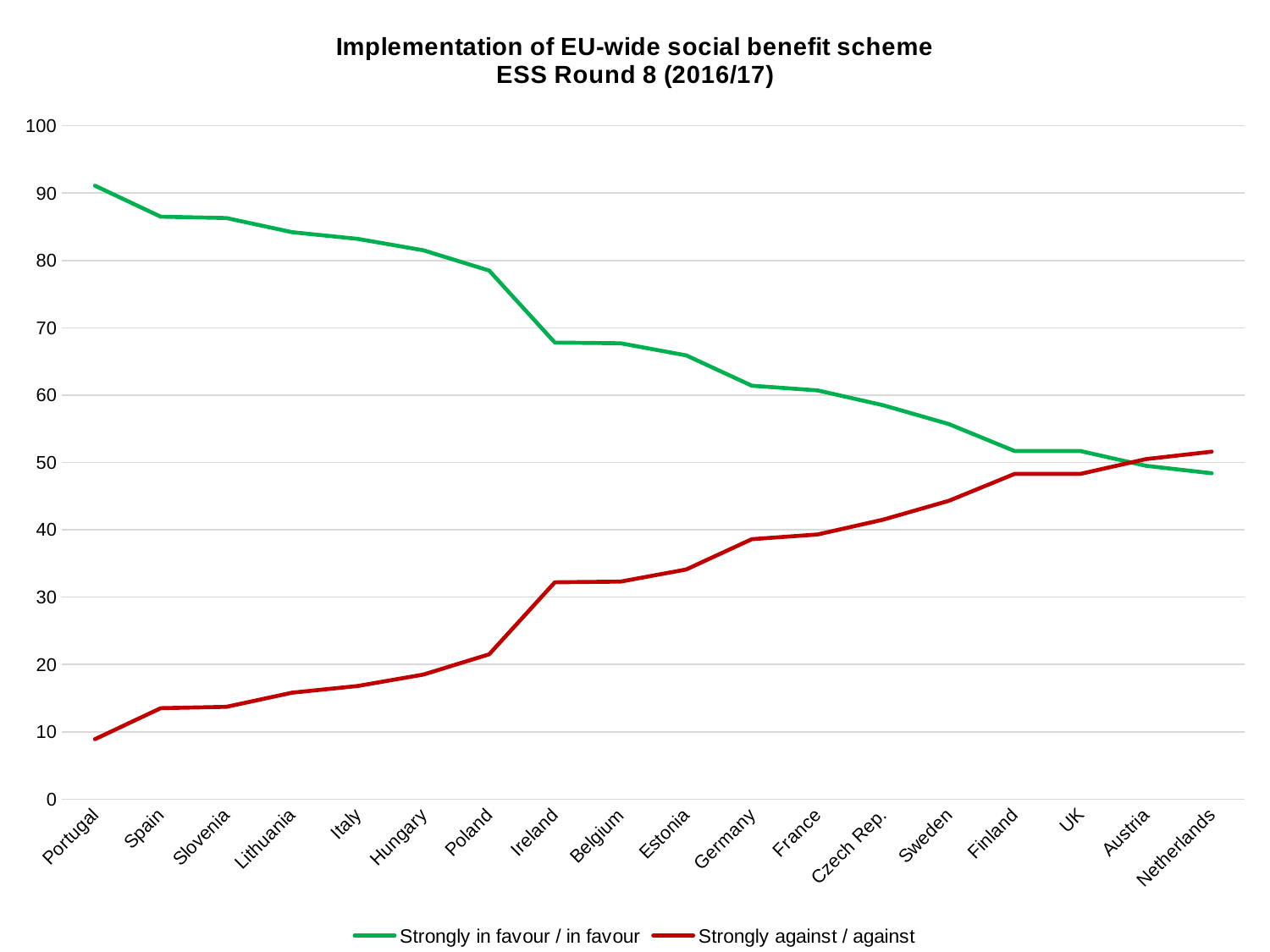
Which country has the highest value for 'Strongly against / against'? Netherlands Which country has the highest value for 'Strongly in favour / in favour'? Portugal Which country has the lowest value for 'Strongly in favour / in favour'? Netherlands What colour is the 'Strongly against / against' line? red Is the 'Strongly against / against' value for Finland greater or less than 40? greater How many countries are shown along the x axis? 18 Is the 'Strongly in favour / in favour' value for Ireland greater or less than 70? less Which country has the lowest value for 'Strongly against / against'? Portugal What kind of chart is shown on the slide? line chart For Germany, which is larger: 'Strongly in favour / in favour' or 'Strongly against / against'? Strongly in favour / in favour Does the 'Strongly in favour / in favour' line rise or fall from Portugal to Netherlands? fall How many series does the legend list? 2